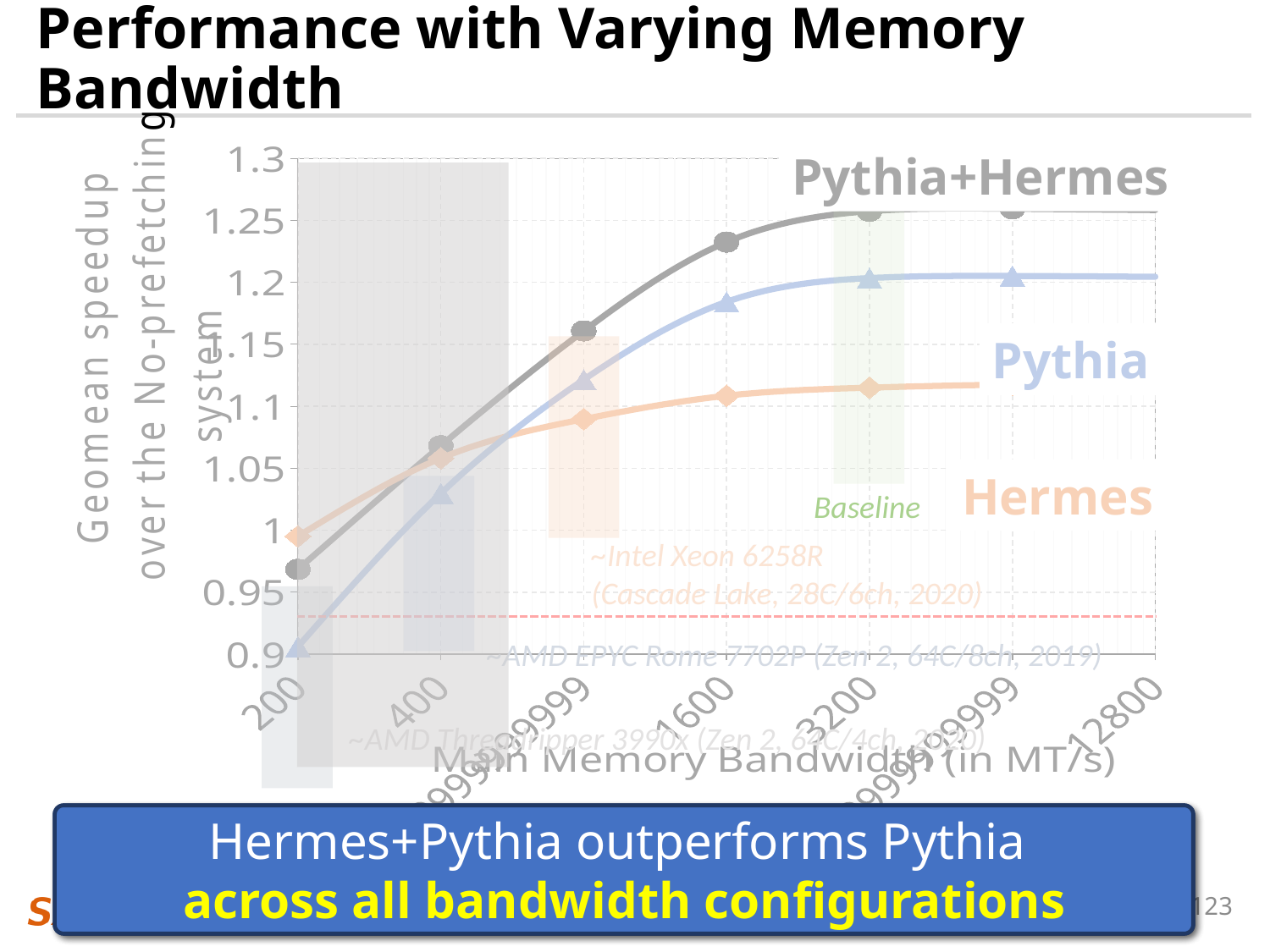
How many series are plotted on the chart? 3 What kind of chart is shown on the slide? line chart Which series reaches the highest geomean speedup at 3200 MT/s? Pythia+Hermes At 1600 MT/s, which series has the larger speedup, Pythia or Hermes? Pythia What is the title of the x axis? Main Memory Bandwidth (in MT/s) Which series has the lowest geomean speedup at 200 MT/s? Pythia Does the Pythia+Hermes speedup rise or fall as memory bandwidth increases from 200 to 3200 MT/s? rise What is the title of the y axis? Geomean speedup over the No-prefetching system Is the value for Hermes at 3200 MT/s greater or less than 1.15? less Is the value for Pythia at 200 MT/s greater or less than 1? less Is the value for Pythia+Hermes at 1600 MT/s greater or less than 1.2? greater